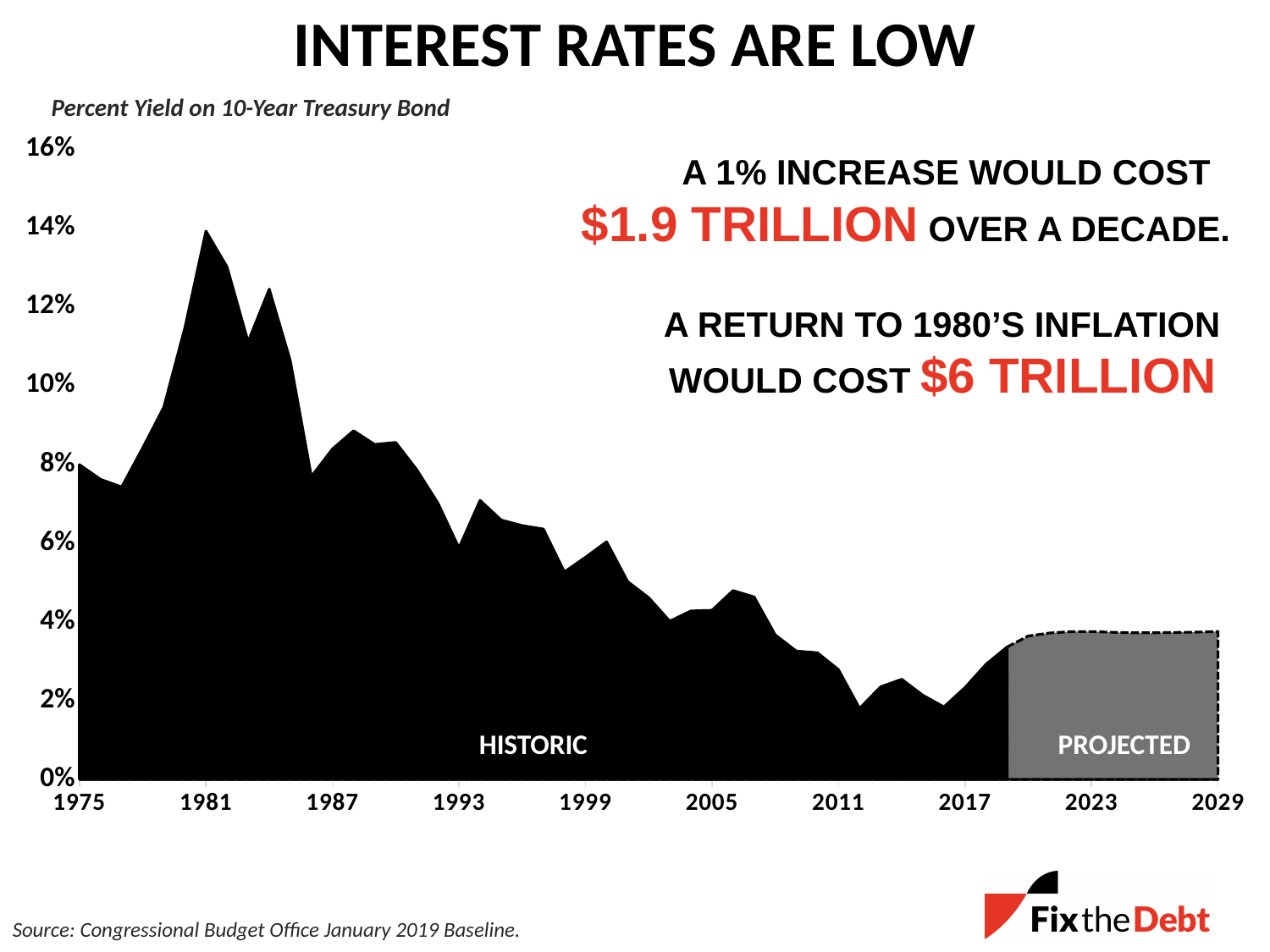
Does the yield generally rise or fall from 1981 to 2017? Fall How many year labels are shown on the x axis? 10 Which labeled year on the x axis shows the highest yield? 1981 Is the projected yield in 2029 greater or less than 4%? less What kind of chart is shown on the slide? Area chart What quantity does the chart plot, according to the label above the y axis? Percent Yield on 10-Year Treasury Bond Is the yield in 2011 greater or less than 4%? less Is the yield in 1981 greater or less than 12%? greater What is the title of the slide? INTEREST RATES ARE LOW Which year has the higher yield, 1981 or 2011? 1981